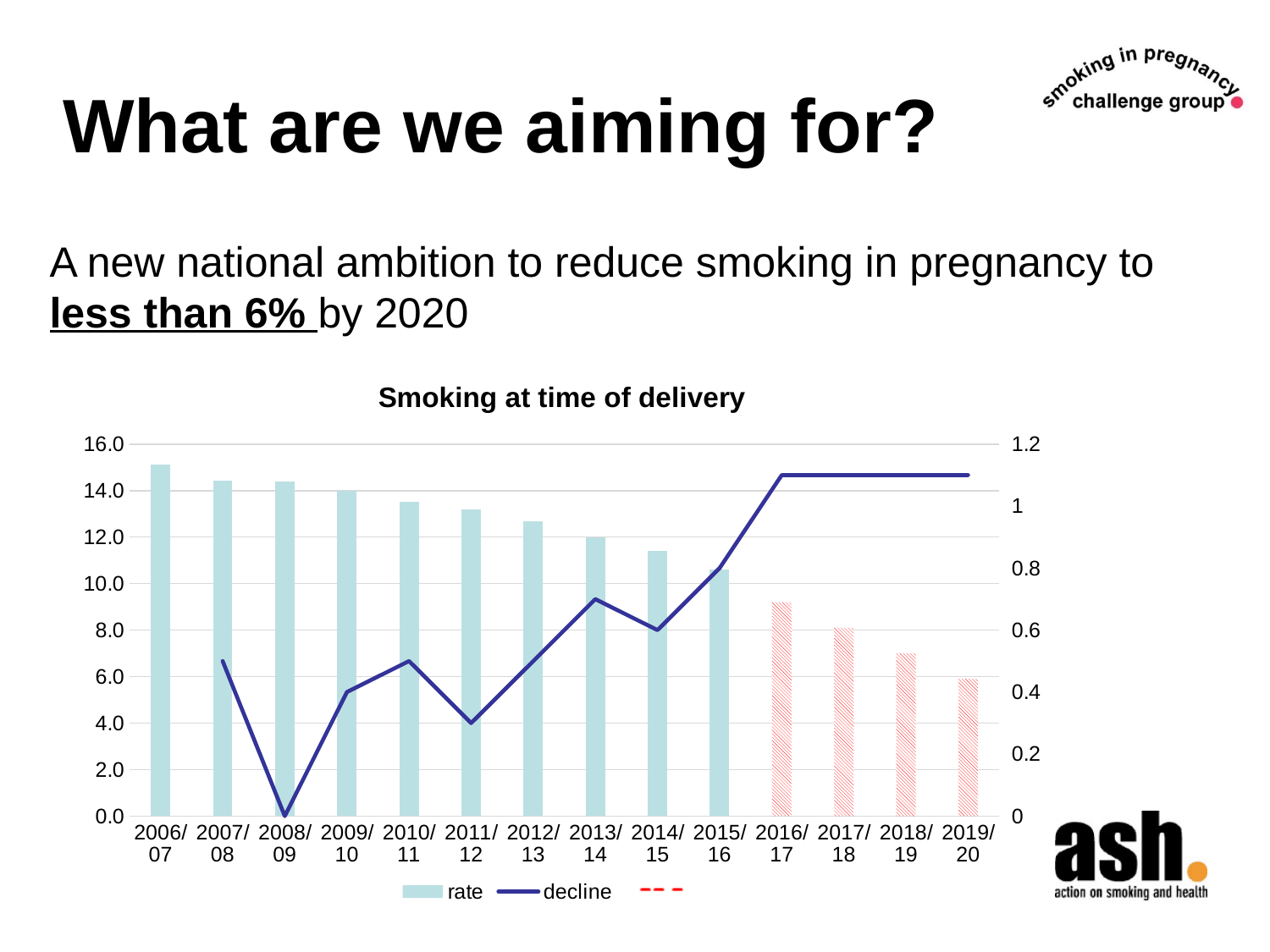
What is the title of the chart? Smoking at time of delivery Which is larger, the rate for 2013/14 or the rate for 2014/15? 2013/14 Is the decline value for 2016/17 greater or less than 1 on the right-hand axis? greater Is the rate for 2006/07 greater or less than 14.0? greater What kind of chart is shown on the slide? A combined bar and line chart Which year has the highest rate bar? 2006/07 Which year has the lowest rate bar? 2019/20 Do the rate bars rise or fall from 2006/07 to 2019/20? fall Is the rate for 2015/16 greater or less than 10.0? greater Which year has the lowest value on the decline line? 2008/09 How many years are shown on the x axis? 14